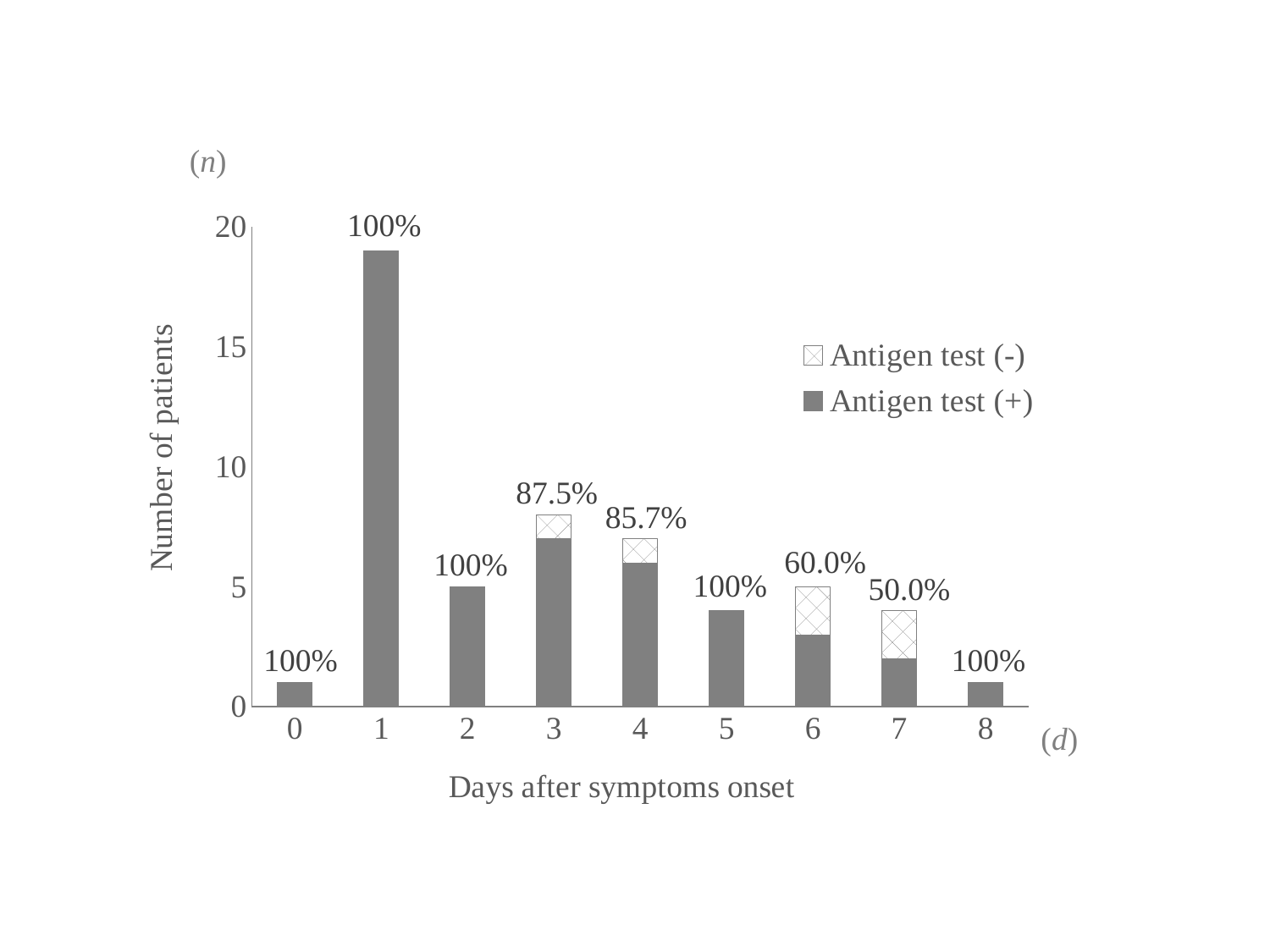
How many series does the legend list? 2 What percentage label is shown above the bar for day 6? 60.0% Which day has the lowest percentage label? 7 What percentage label is shown above the bar for day 4? 85.7% Which day after symptoms onset has the highest number of patients? 1 Which bar is taller, day 2 or day 4? day 4 How many days (categories) are shown on the x axis? 9 What kind of chart is shown on the slide? stacked bar chart Is the number of patients for day 3 greater or less than 10? less What percentage label is shown above the bar for day 3? 87.5% What percentage label is shown above the bar for day 7? 50.0% Is the number of patients for day 1 greater or less than 15? greater